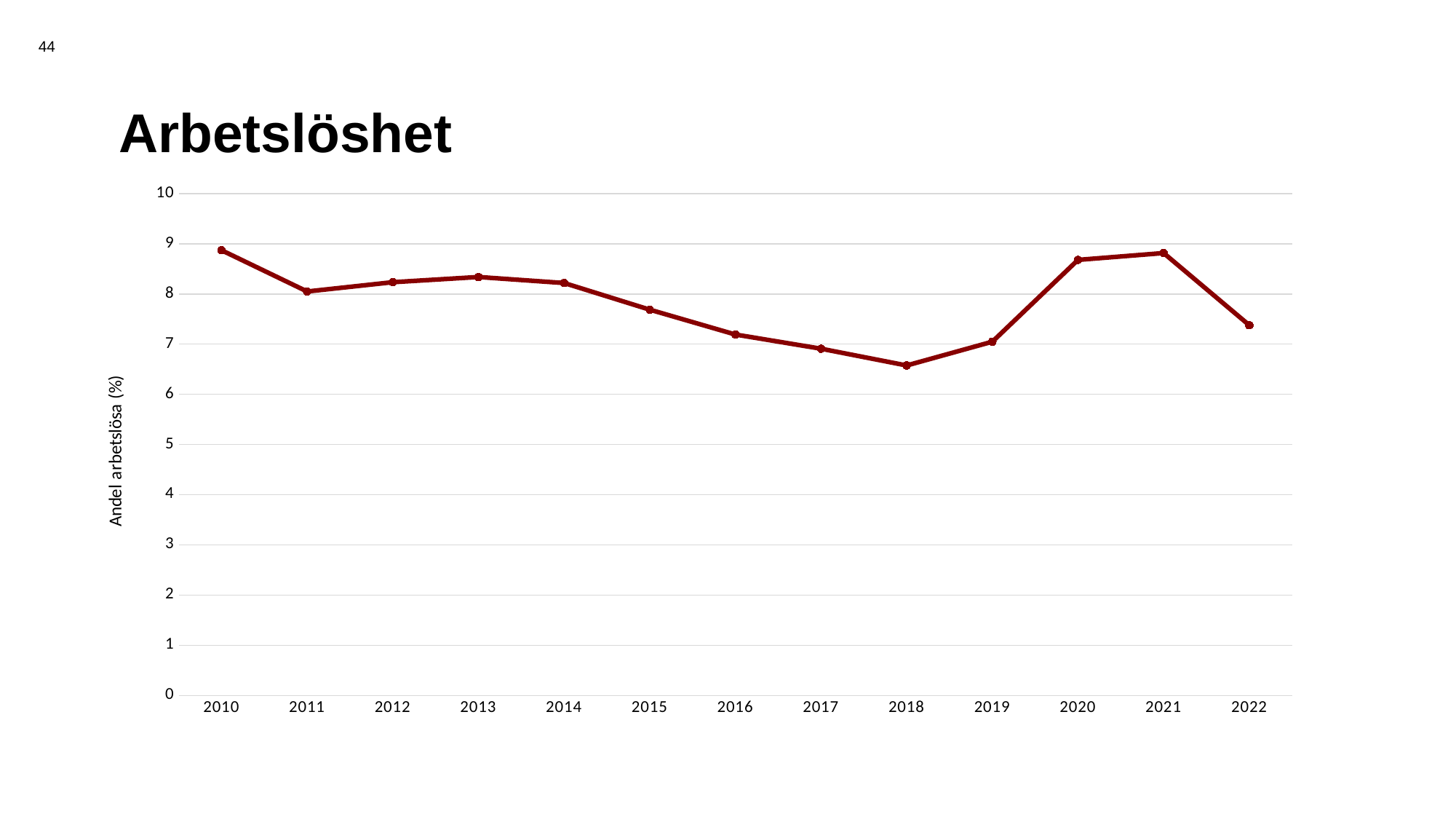
How many years are plotted on the x axis? 13 What kind of chart is shown on the slide? line chart Is the value for 2010 greater or less than 8? greater Is the value for 2022 greater or less than 8? less What is the label on the y axis? Andel arbetslösa (%) Which year has the lowest unemployment value? 2018 Is the value for 2020 greater or less than 8? greater Which is larger, the value for 2019 or the value for 2020? 2020 Which is larger, the value for 2021 or the value for 2022? 2021 Do the values rise or fall from 2014 to 2018? fall